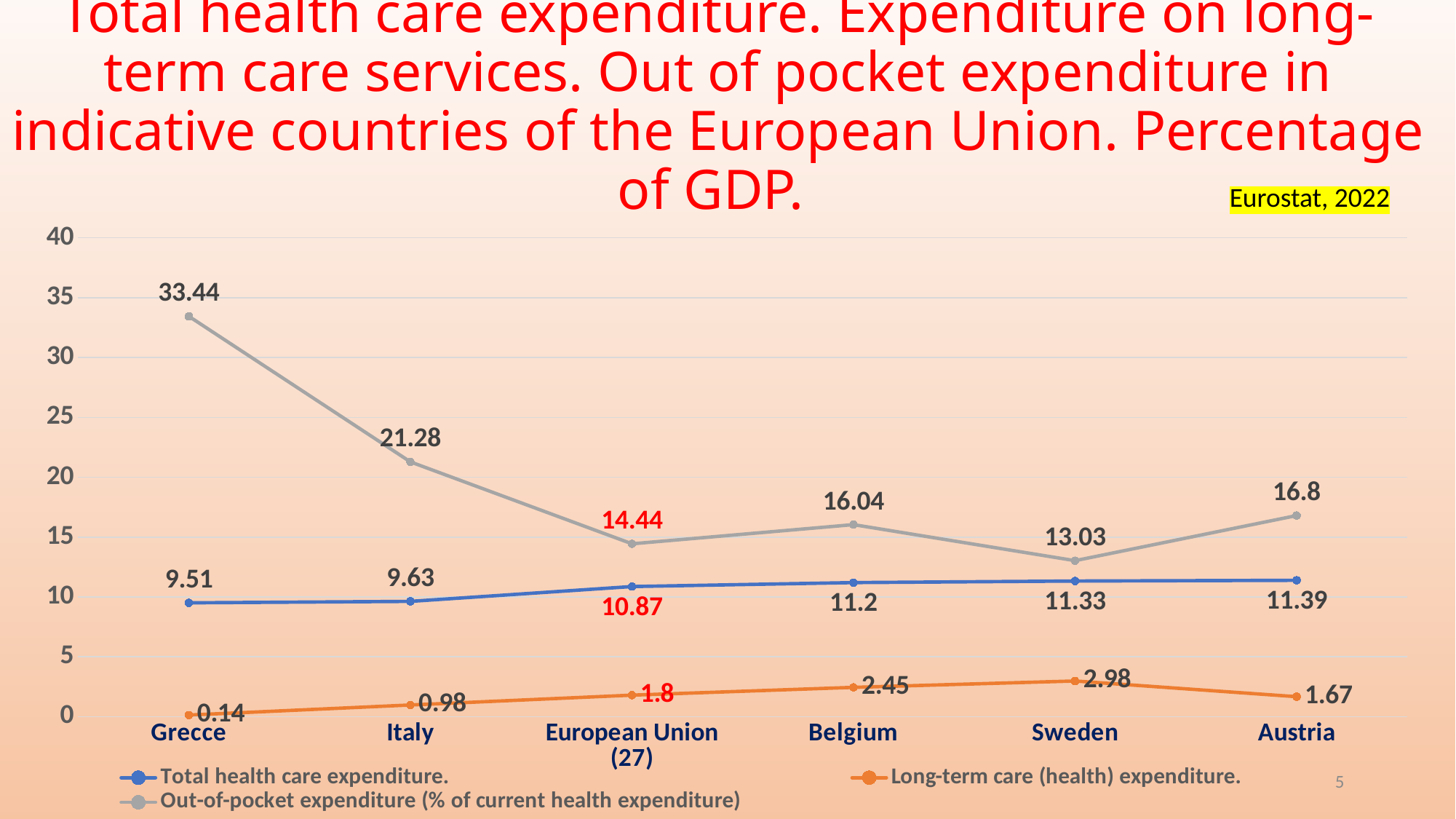
Which category has the lowest long-term care (health) expenditure value? Grecce What is the difference between the out-of-pocket expenditure values for Grecce and Italy? 12.16 How many countries/categories are plotted along the x axis? 6 What source is cited on the slide for the chart data? Eurostat, 2022 Which category has the highest out-of-pocket expenditure value? Grecce What is the out-of-pocket expenditure value for Grecce? 33.44 What is the long-term care (health) expenditure value for Sweden? 2.98 Which is larger, the out-of-pocket expenditure value for Belgium or for Sweden? Belgium Does the total health care expenditure series rise or fall from Grecce to Austria? rise What is the total health care expenditure value for Belgium? 11.2 How many series does the legend list? 3 What kind of chart is shown on the slide? line chart